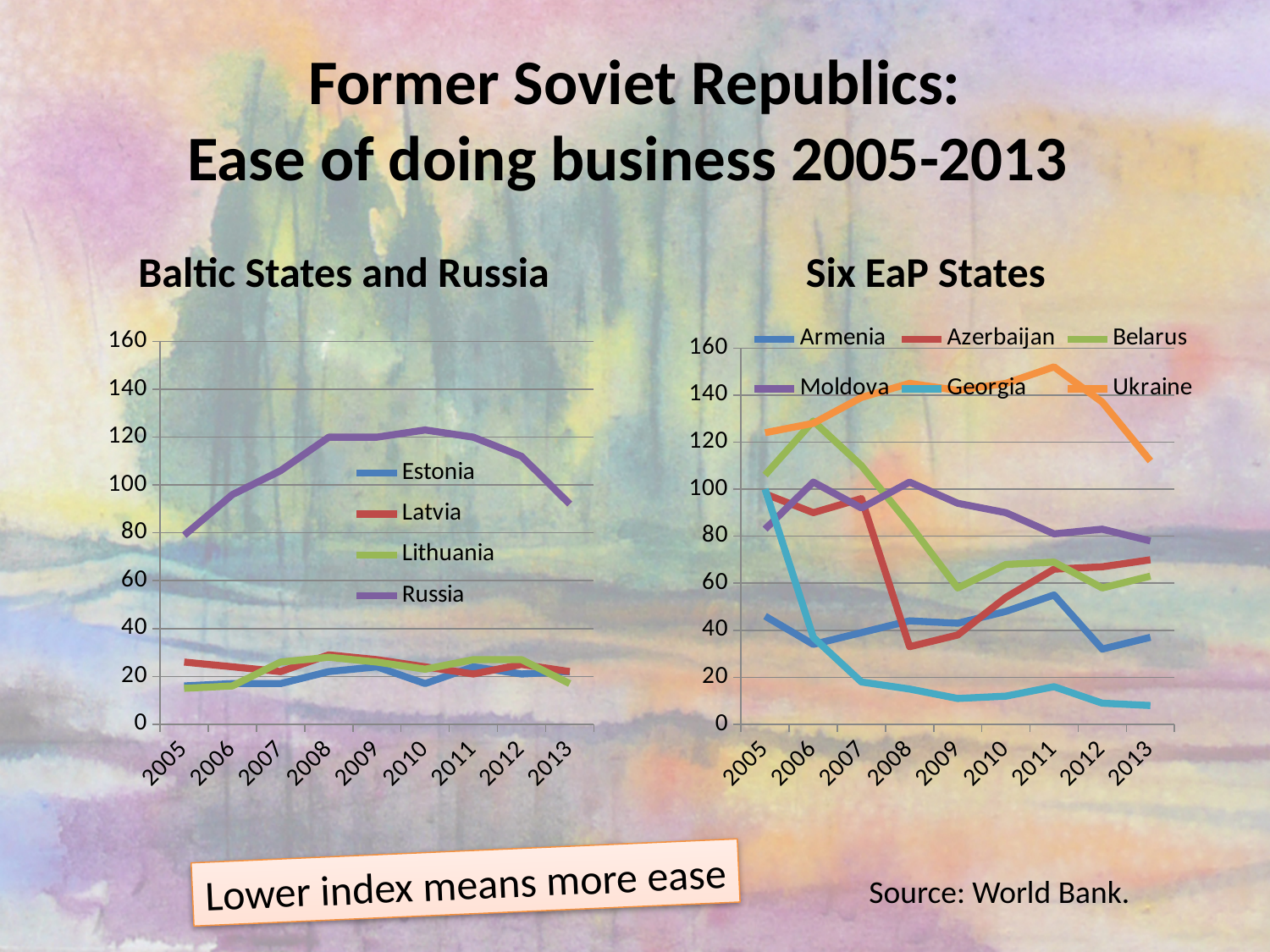
In the 'Baltic States and Russia' chart, which country has the highest values across the whole period? Russia In the 'Baltic States and Russia' chart, is the value for Russia in 2010 greater or less than 100? greater In the 'Six EaP States' chart, is the value for Ukraine in 2011 greater or less than 140? greater In the 'Six EaP States' chart, does the Georgia line rise or fall from 2005 to 2013? fall In the 'Six EaP States' chart, is the value for Georgia in 2013 greater or less than 20? less In the 'Six EaP States' chart, which country has the highest value in 2013? Ukraine How many series does the legend of the 'Six EaP States' chart list? 6 What type of chart is the 'Baltic States and Russia' chart? line chart In the 'Six EaP States' chart, which is larger in 2013: Ukraine or Armenia? Ukraine In the 'Six EaP States' chart, which country has the lowest value in 2013? Georgia How many years are shown on the x axis of the 'Six EaP States' chart? 9 How many series does the legend of the 'Baltic States and Russia' chart list? 4